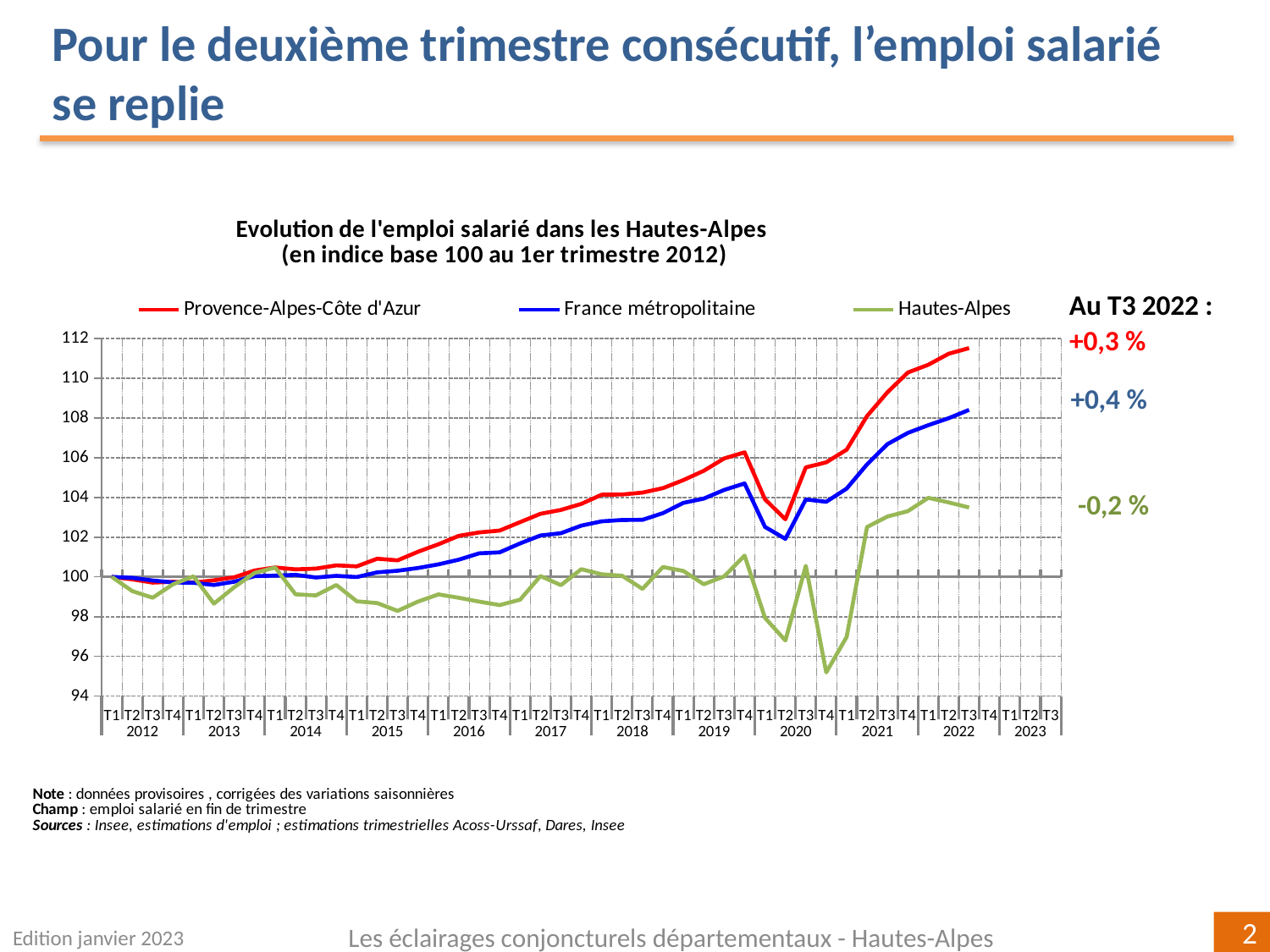
Is the value for France métropolitaine at T3 2022 greater or less than 106? greater Which series has the lowest value at T3 2022? Hautes-Alpes At T2 2020, which is lower: Hautes-Alpes or France métropolitaine? Hautes-Alpes Is the value for Hautes-Alpes at T4 2020 greater or less than 98? less What change is annotated for France métropolitaine at T3 2022? +0,4 % Is the value for Provence-Alpes-Côte d'Azur at T3 2022 greater or less than 110? greater Which series has the highest value at T3 2022? Provence-Alpes-Côte d'Azur How many series does the legend list? 3 What change is annotated for Hautes-Alpes at T3 2022? -0,2 % Which series are listed in the legend? Provence-Alpes-Côte d'Azur, France métropolitaine, Hautes-Alpes What is the title of the chart? Evolution de l'emploi salarié dans les Hautes-Alpes (en indice base 100 au 1er trimestre 2012) What kind of chart is shown on the slide? line chart